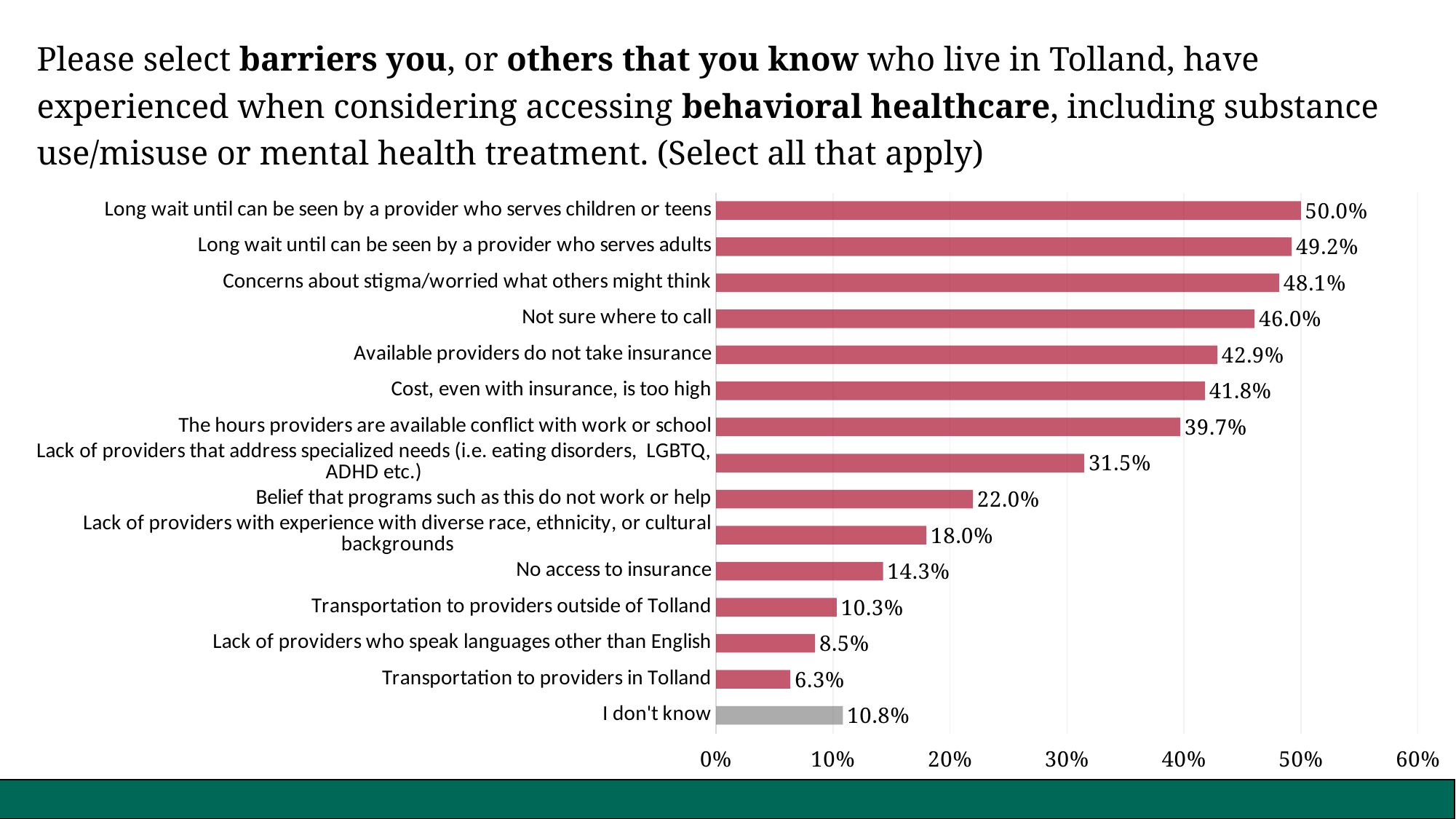
What is the difference between "Available providers do not take insurance" and "No access to insurance"? 28.6% Which barrier has the lowest percentage? Transportation to providers in Tolland What is the difference between the two "Long wait" barriers (children or teens vs. adults)? 0.8% Which is larger: "Transportation to providers outside of Tolland" or "Lack of providers who speak languages other than English"? Transportation to providers outside of Tolland What kind of chart is shown on the slide? Bar chart Which barrier has the highest percentage? Long wait until can be seen by a provider who serves children or teens What percentage of respondents selected "Not sure where to call" as a barrier? 46.0% Which bar is shown in a different colour (grey) from the others? I don't know What percentage is shown for "I don't know"? 10.8% Is the value for "Belief that programs such as this do not work or help" greater or less than 30%? less What is the value shown for "Cost, even with insurance, is too high"? 41.8% How many barrier categories are plotted in the chart? 15